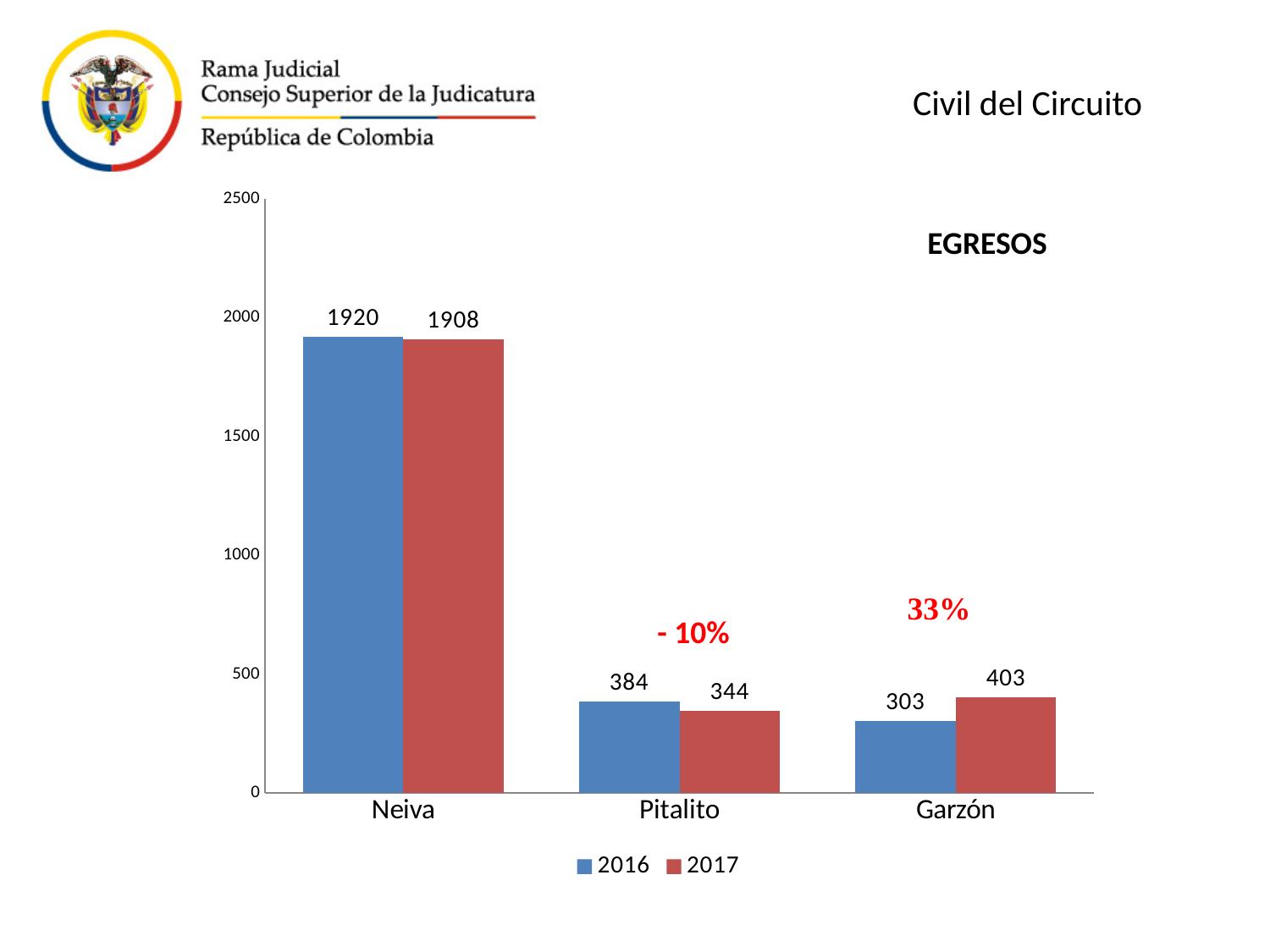
What is the value for Pitalito in 2017? 344 What is the value for Neiva in 2016? 1920 Which category has the highest value in 2017? Neiva Which category has the lowest value in 2016? Garzón What is the difference between the 2016 and 2017 values for Pitalito? 40 Which is larger for Garzón, the 2016 value or the 2017 value? 2017 What is the value for Garzón in 2016? 303 How many categories are shown on the x axis? 3 How many series does the legend list? 2 What percentage change is annotated in red above the Garzón bars? 33% What is the difference between the 2017 and 2016 values for Garzón? 100 What kind of chart is shown on the slide? bar chart